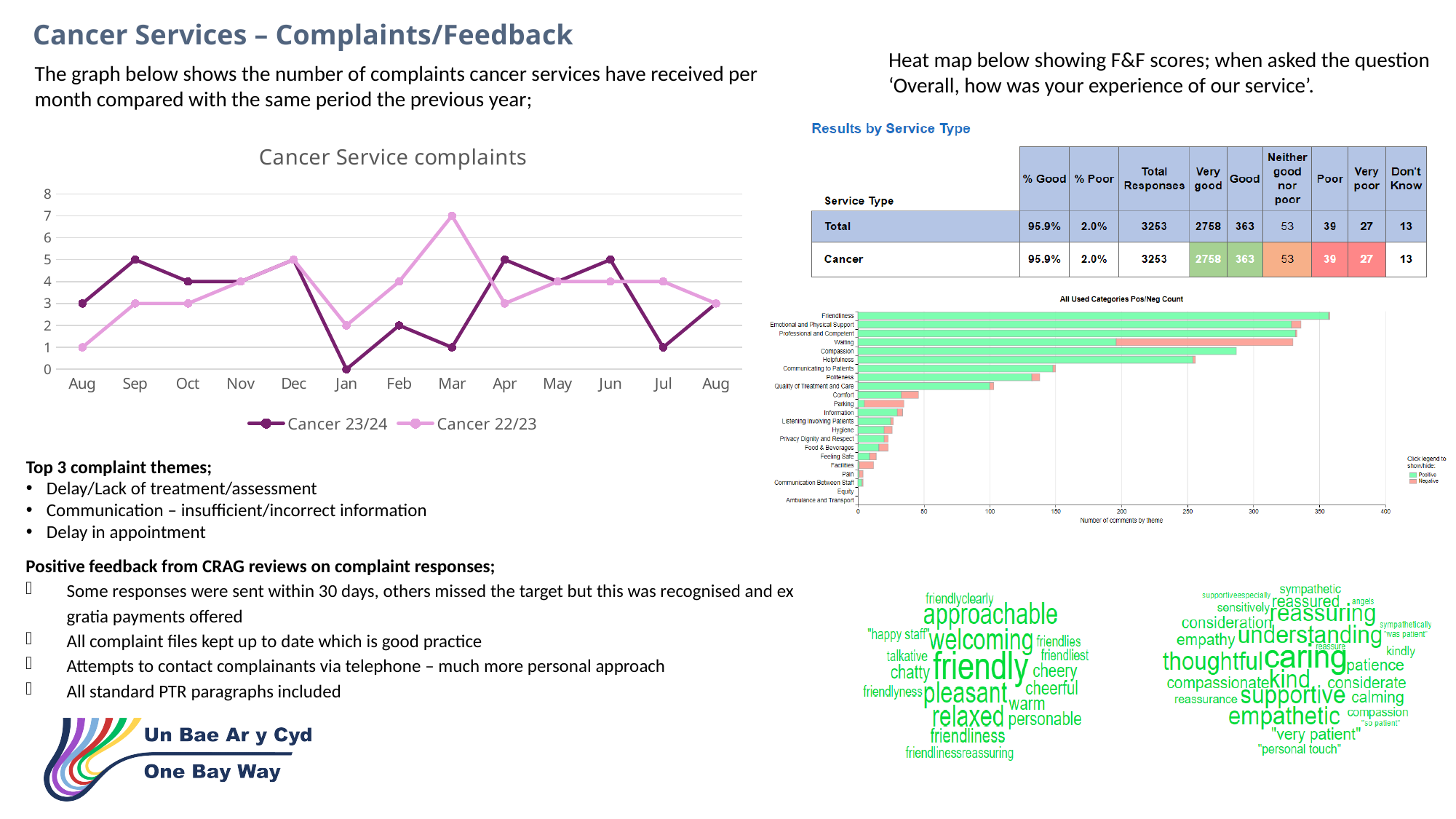
In the 'Cancer Service complaints' chart, which series has the larger value in Sep, Cancer 23/24 or Cancer 22/23? Cancer 23/24 In the 'Cancer Service complaints' chart, what kind of chart is it? line chart In the 'Cancer Service complaints' chart, what is the value for Cancer 23/24 in Jul? 1 In the 'Cancer Service complaints' chart, what is the value for Cancer 23/24 in Jan? 0 In the 'Cancer Service complaints' chart, which month has the lowest value for Cancer 23/24? Jan In the 'All Used Categories Pos/Neg Count' chart, which category has the longest bar? Friendliness In the 'Cancer Service complaints' chart, which month has the highest value for Cancer 22/23? Mar In the 'All Used Categories Pos/Neg Count' chart, is the total bar length for Waiting greater or less than 300? greater In the 'Cancer Service complaints' chart, how many series does the legend list? 2 In the 'Cancer Service complaints' chart, what is the value for Cancer 22/23 in Mar? 7 In the 'Cancer Service complaints' chart, what is the difference between Cancer 22/23 and Cancer 23/24 in Mar? 6 In the 'Cancer Service complaints' chart, how many months are shown on the x axis? 13